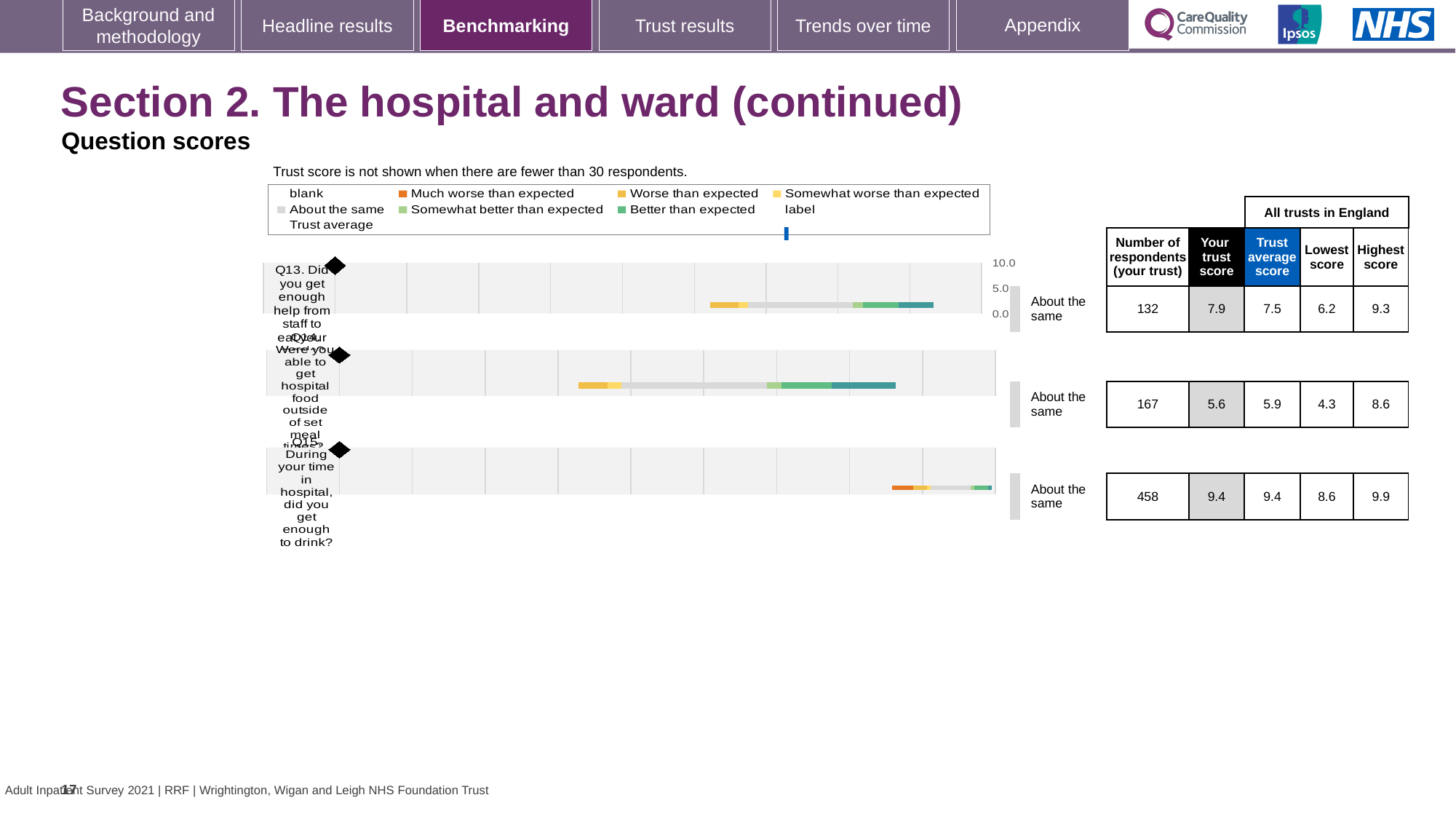
What is the highest score across all trusts in England for Q15 (did you get enough to drink?)? 9.9 What is the difference between the highest and lowest scores for Q15? 1.3 For Q14, which is larger: the trust score or the trust average score? Trust average score For Q13, how much higher is the trust score than the trust average score? 0.4 How many questions are plotted in the benchmarking charts on this slide? 3 What is the trust average score for Q14 (Were you able to get hospital food outside of set meal times?)? 5.9 Which question has the highest trust score on this slide? Q15 What is the trust score for Q13 (Did you get enough help from staff to eat your meals?)? 7.9 Which question has the lowest trust score on this slide? Q14 How many respondents from the trust answered Q15? 458 What kind of chart is used to show the question scores for Q13, Q14 and Q15? Bar chart What benchmark category is shown for Q13? About the same